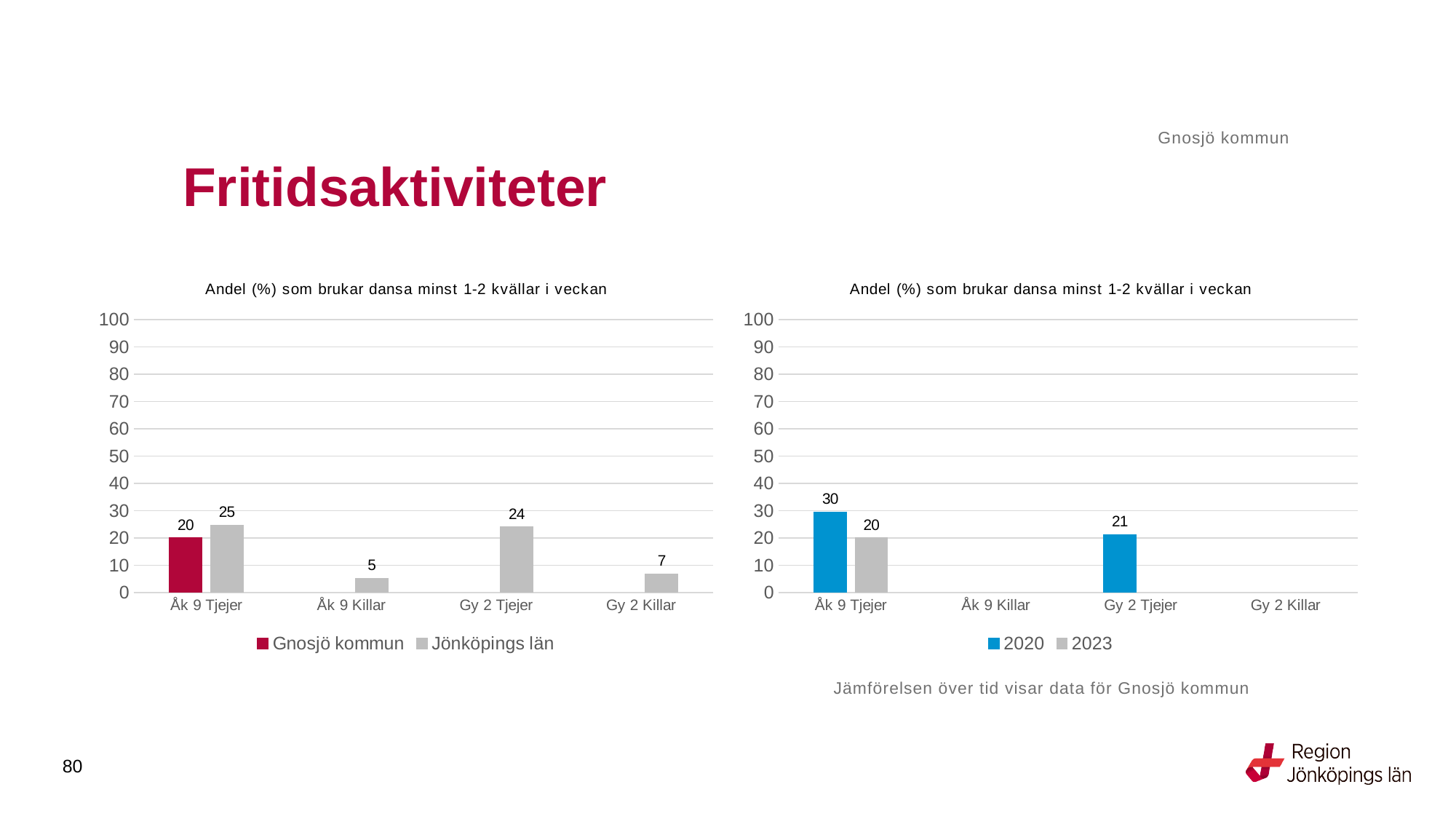
In the left chart, what is the value for Gnosjö kommun for Åk 9 Tjejer? 20 In the left chart, which category has the highest value for Jönköpings län? Åk 9 Tjejer In the right chart, which is larger for Åk 9 Tjejer: the 2020 value or the 2023 value? 2020 In the right chart, what is the value for 2020 for Åk 9 Tjejer? 30 In the left chart, which category has the lowest value for Jönköpings län? Åk 9 Killar In the left chart, what is the difference between the Jönköpings län values for Gy 2 Tjejer and Gy 2 Killar? 17 In the right chart, what is the difference between the 2020 and 2023 values for Åk 9 Tjejer? 10 What kind of chart is the left chart? Bar chart How many series does the legend of the right chart list? 2 In the left chart, what is the value for Jönköpings län for Gy 2 Killar? 7 In the left chart, what is the value for Jönköpings län for Åk 9 Tjejer? 25 In the right chart, what is the value for 2023 for Åk 9 Tjejer? 20